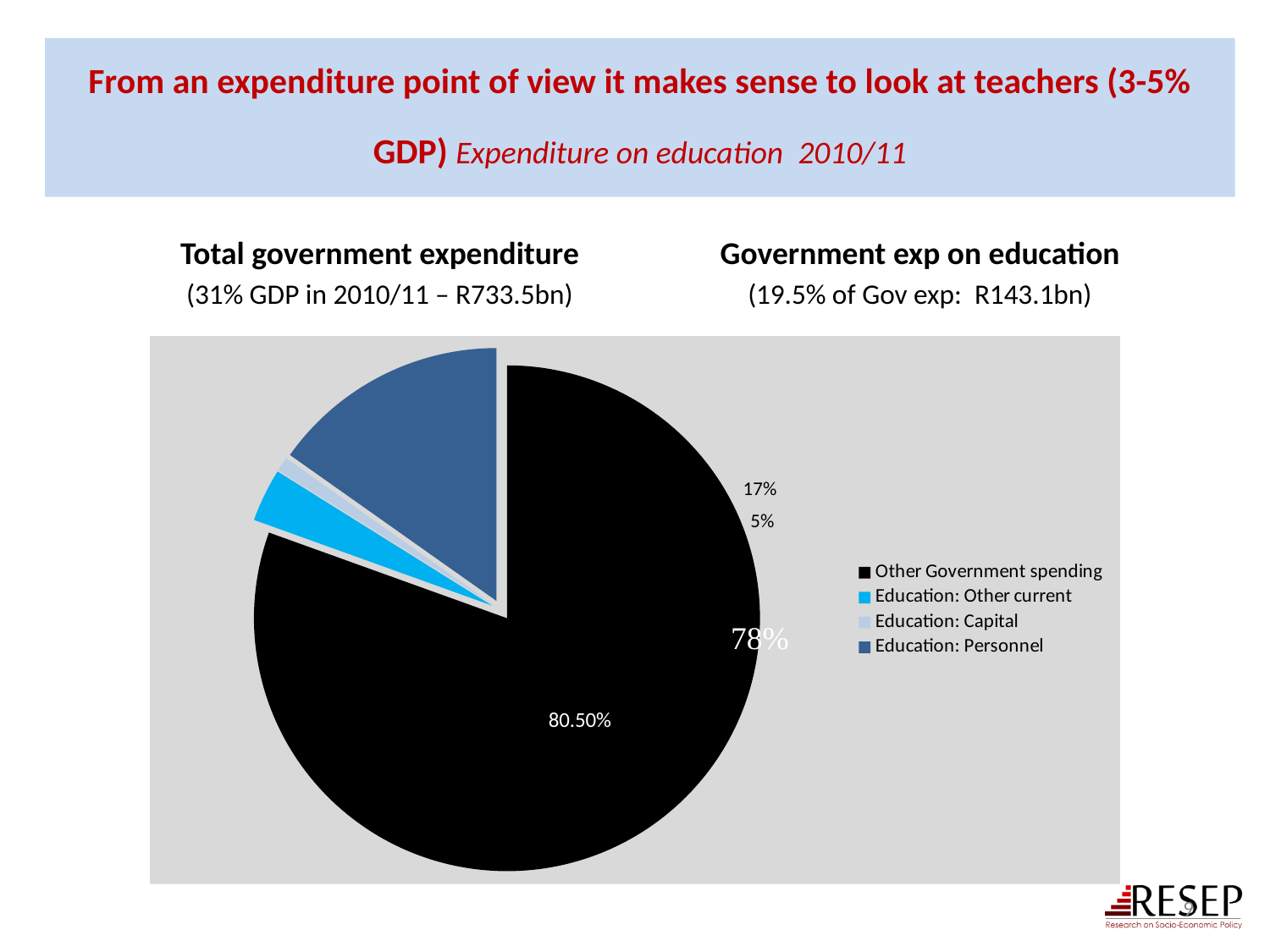
Which category has the smallest slice of the pie? Education: Capital What colour is the Other Government spending slice? black Which legend entry is listed first? Other Government spending How many slices does the pie chart have? 4 What percentage is labelled on the Other Government spending slice? 80.50% Which slice is larger: Education: Other current or Education: Capital? Education: Other current What kind of chart is shown on the slide? pie chart Which category has the largest slice of the pie? Other Government spending Which slice is larger: Education: Personnel or Education: Other current? Education: Personnel Which slice is larger: Other Government spending or Education: Personnel? Other Government spending How many entries does the chart legend list? 4